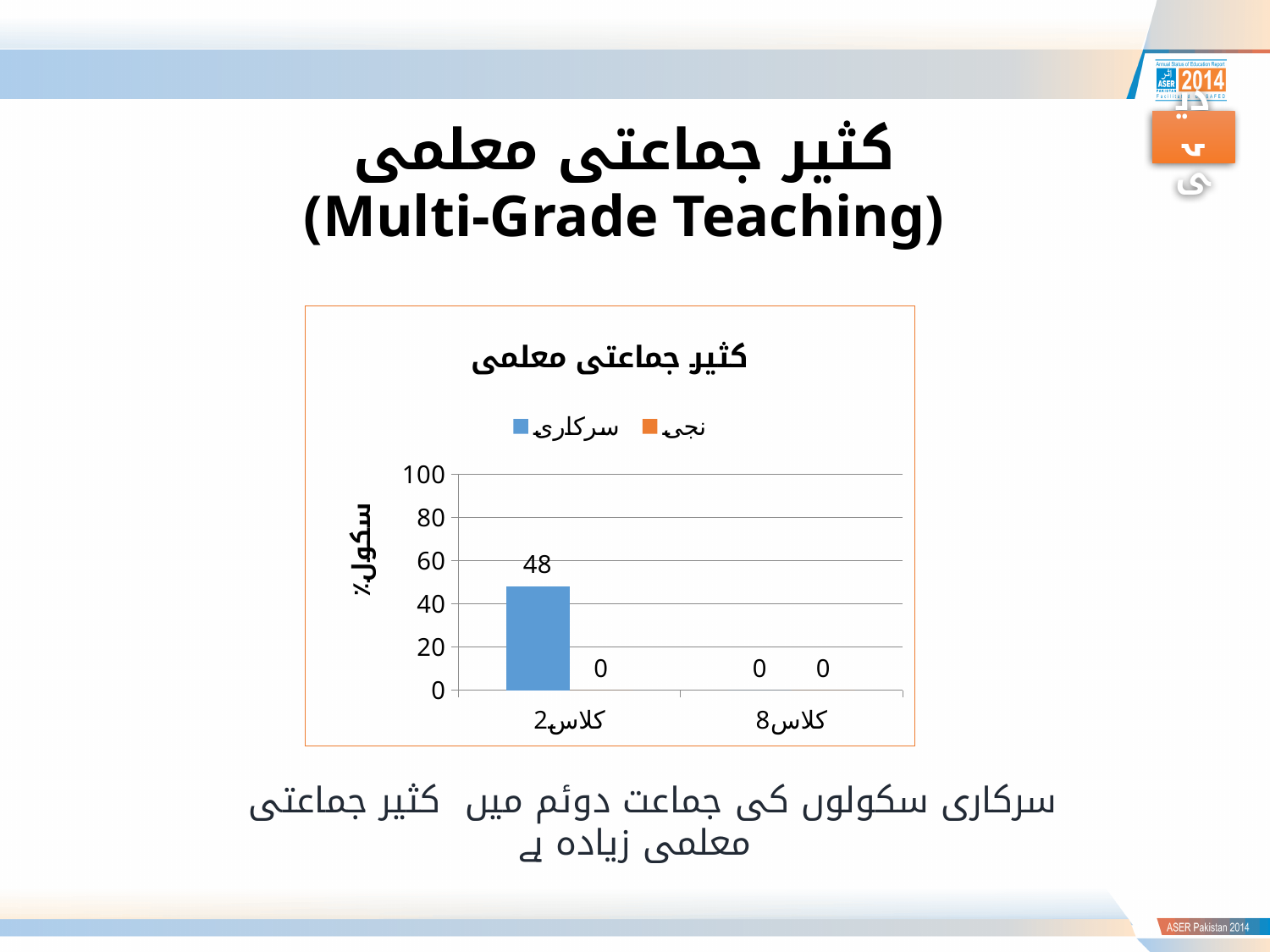
What is the value for سرکاری (government) in کلاس2 (Class 2)? 48 Which category has the highest value for سرکاری (government)? کلاس2 How many series does the legend list? 2 Is the value for سرکاری (government) in کلاس2 (Class 2) greater or less than 40? greater How many categories are shown on the x axis? 2 Which is larger in کلاس2 (Class 2): the سرکاری (government) value or the نجی (private) value? سرکاری (government) What kind of chart is shown on the slide? bar chart What is the value for نجی (private) in کلاس2 (Class 2)? 0 What is the difference between the سرکاری (government) and نجی (private) values in کلاس2 (Class 2)? 48 What colour represents the سرکاری (government) series in the legend? blue What is the value for سرکاری (government) in کلاس8 (Class 8)? 0 What is the value for نجی (private) in کلاس8 (Class 8)? 0